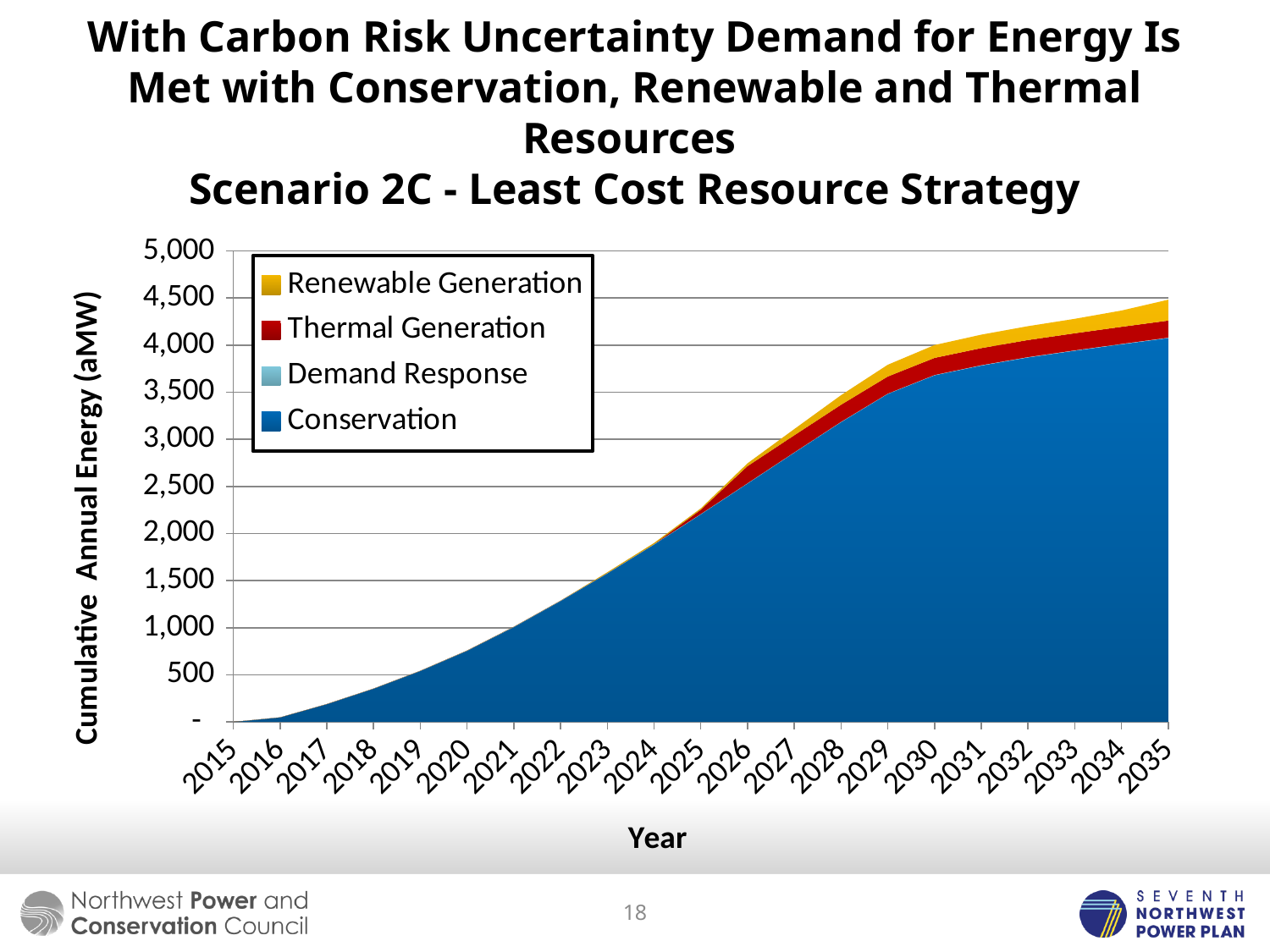
Is the total cumulative annual energy in 2020 greater or less than 1,000 aMW? less How many series does the legend list? 4 Is the total cumulative annual energy in 2030 greater or less than 3,500 aMW? greater What is the label of the y axis? Cumulative Annual Energy (aMW) Is the total cumulative annual energy in 2025 greater or less than 2,000 aMW? greater Does the total cumulative annual energy rise or fall from 2015 to 2035? Rise Which series is shown in yellow in the legend? Renewable Generation How many years are shown along the x axis? 21 What kind of chart is shown on the slide? Stacked area chart Which series accounts for the largest share of the cumulative annual energy in 2035? Conservation